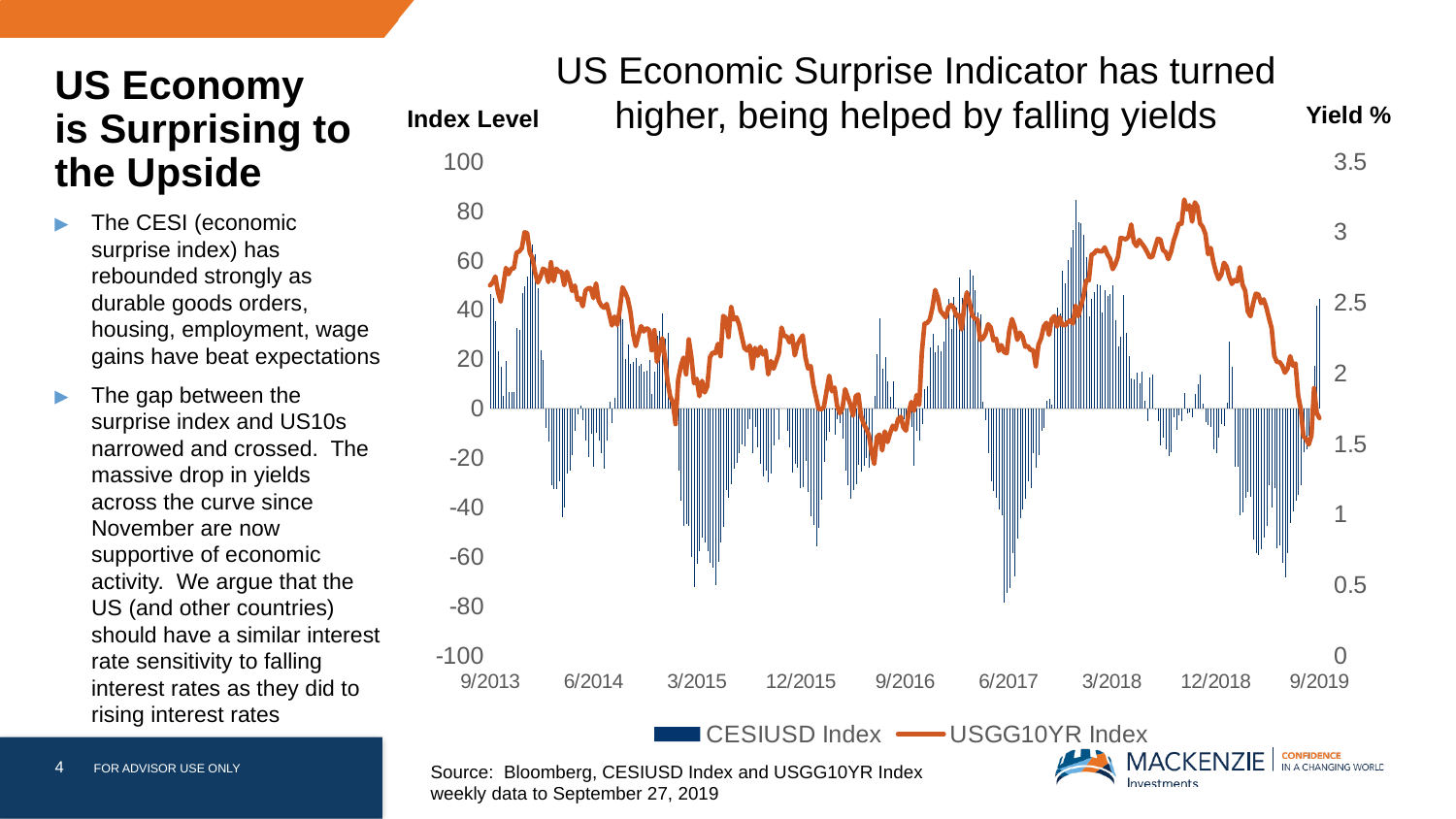
Is the value of the USGG10YR Index line at 12/2018 greater or less than 2.5? greater What kind of chart is shown on the slide? A combination bar and line chart Does the USGG10YR Index line rise or fall between 12/2018 and 9/2019? fall How many date labels are shown along the x axis? 9 Is the lowest CESIUSD Index bar value greater or less than -60? less Is the peak value of the USGG10YR Index line greater or less than 3? greater What is the maximum value shown on the right-hand Yield % axis? 3.5 How many series does the legend list? 2 Which series is drawn as a line in the chart? USGG10YR Index What is the title of the chart? US Economic Surprise Indicator has turned higher, being helped by falling yields